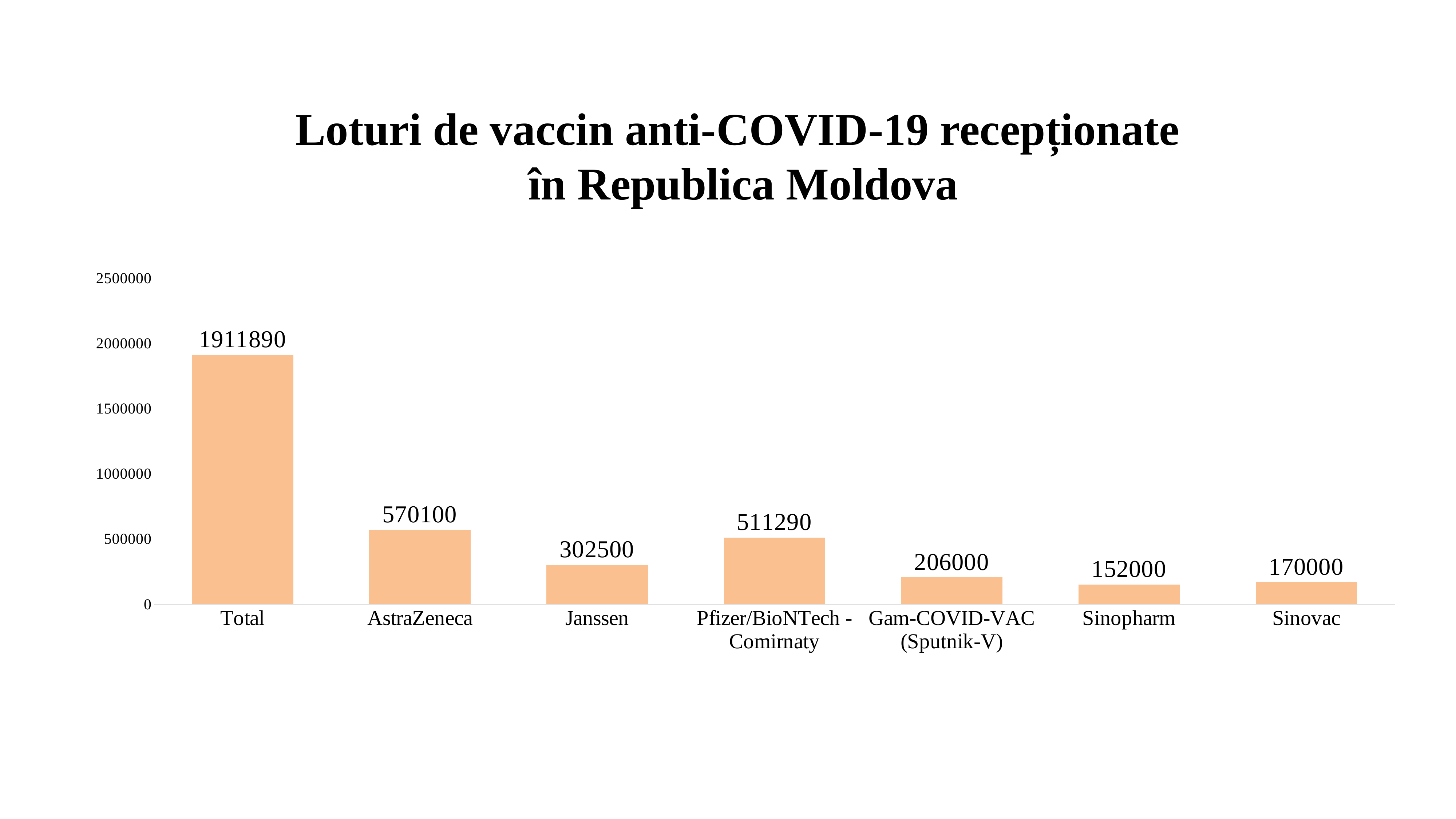
What is the value for Pfizer/BioNTech - Comirnaty? 511290 Which category has the lowest value? Sinopharm What type of chart is shown on the slide? bar chart What is the difference between the values for AstraZeneca and Pfizer/BioNTech - Comirnaty? 58810 Excluding the Total bar, which vaccine has the highest value? AstraZeneca What is the value for Janssen? 302500 What is the value shown for the Total bar? 1911890 Which is larger, the value for Sinovac or the value for Sinopharm? Sinovac What is the value for Gam-COVID-VAC (Sputnik-V)? 206000 What is the value for AstraZeneca? 570100 How many bars are shown in the chart? 7 Is the value for Janssen greater or less than 500000? less